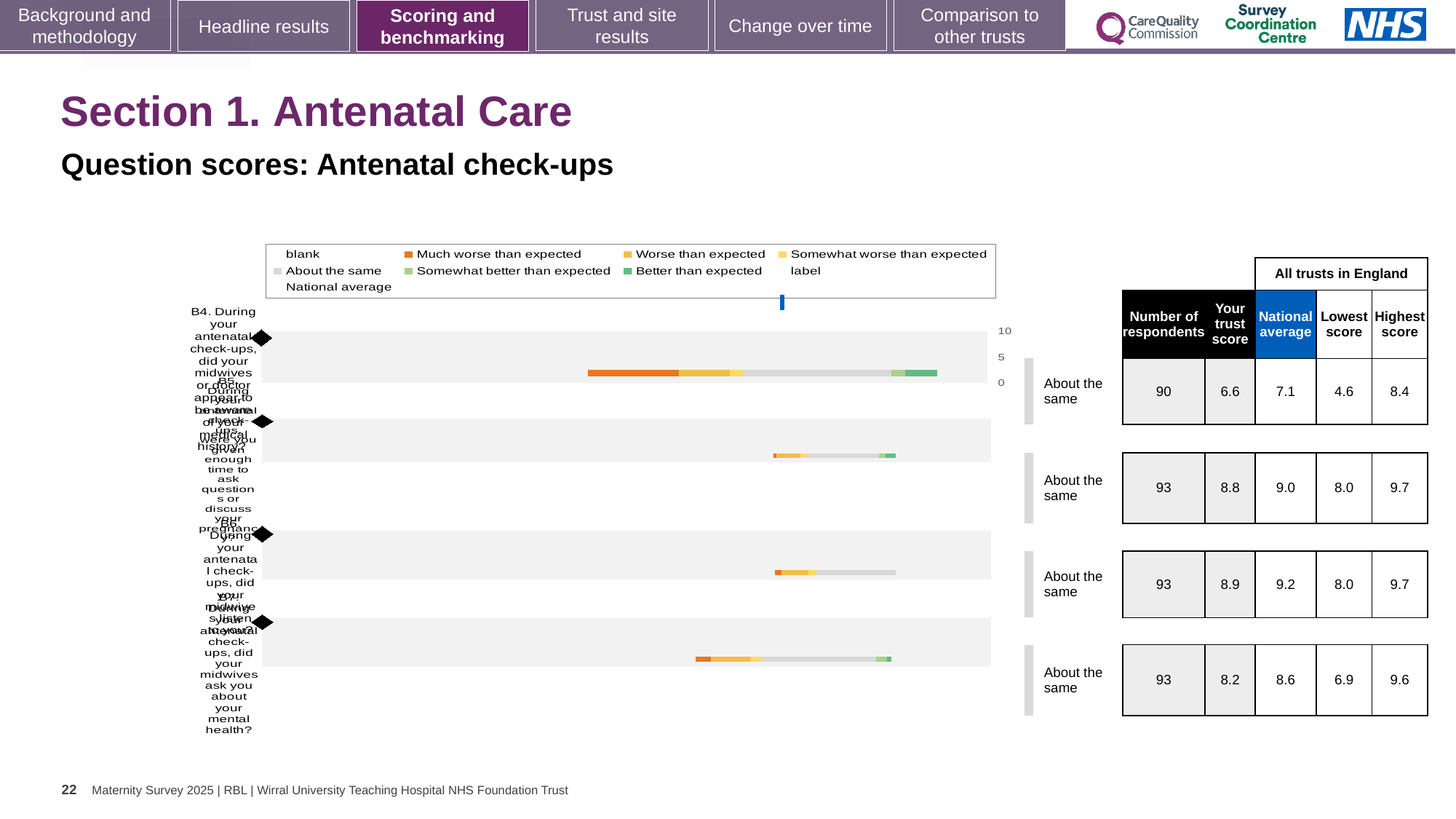
Which question label is shown for the top bar of the chart? B4. During your antenatal check-ups, did your midwives or doctor appear to be aware of your medical history? What is the lowest value shown on the chart's numeric axis? 0 What is the highest value shown on the chart's numeric axis? 10 What kind of chart is shown on the slide? bar chart How many question categories (bars) does the chart show? 4 Which question label is shown for the bottom bar of the chart? B7. During your antenatal check-ups, did your midwives ask you about your mental health?